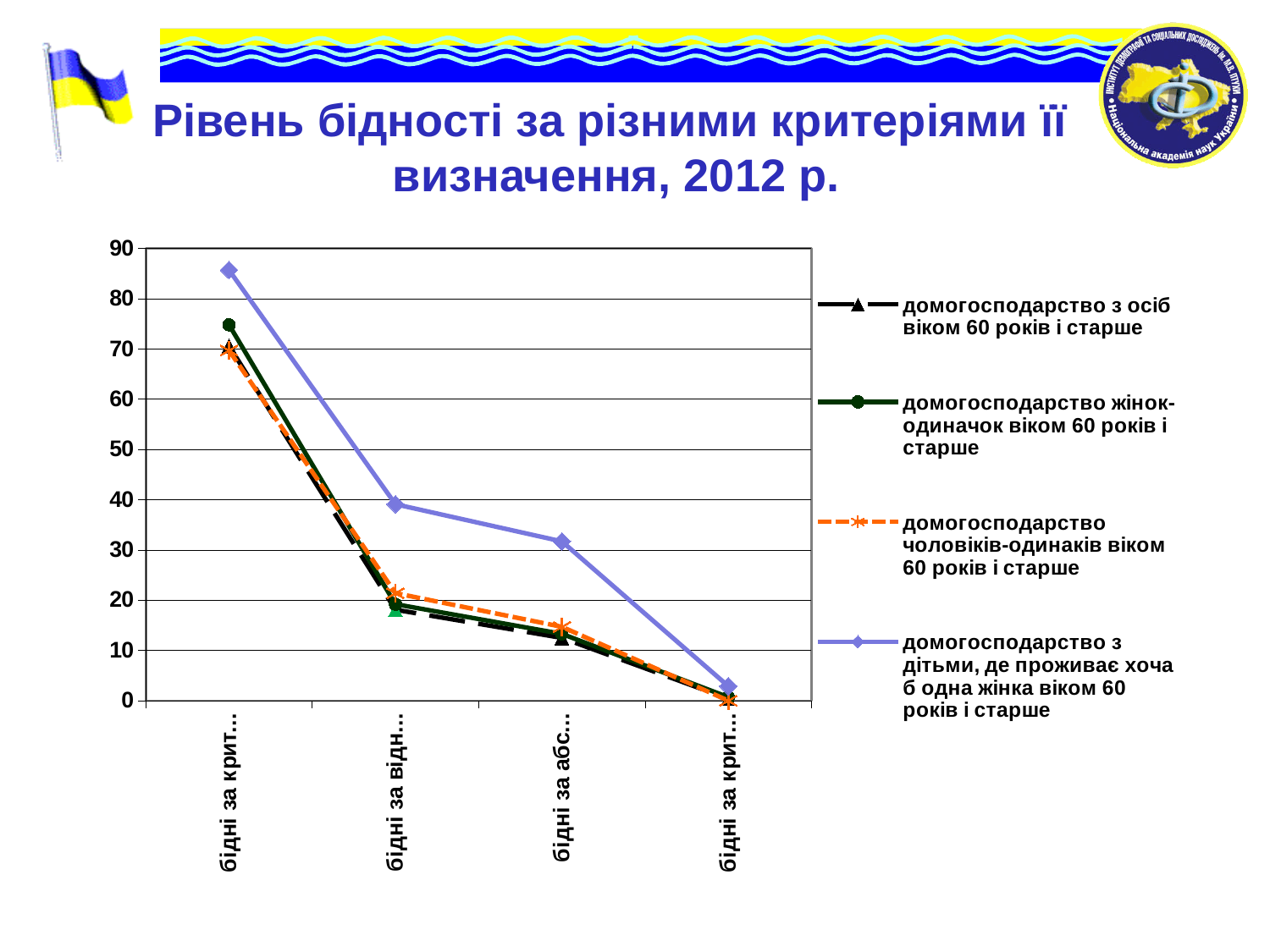
How many series does the legend list? 4 What is the title of the chart on the slide? Рівень бідності за різними критеріями її визначення, 2012 р. Which series is drawn with a dashed orange line? домогосподарство чоловіків-одинаків віком 60 років і старше What kind of chart is shown on the slide? line chart Do the values of the series 'домогосподарство з дітьми, де проживає хоча б одна жінка віком 60 років і старше' rise or fall from left to right along the x axis? fall Is the value for 'домогосподарство жінок-одиначок віком 60 років і старше' at the first category greater or less than 70? greater Is the value for 'домогосподарство з дітьми, де проживає хоча б одна жінка віком 60 років і старше' at the first category greater or less than 80? greater Is the value for 'домогосподарство з дітьми, де проживає хоча б одна жінка віком 60 років і старше' at the second category greater or less than 30? greater How many categories are plotted along the x axis? 4 Which series has the highest value at the first category on the x axis? домогосподарство з дітьми, де проживає хоча б одна жінка віком 60 років і старше At the third category, which series has the larger value: 'домогосподарство з дітьми, де проживає хоча б одна жінка віком 60 років і старше' or 'домогосподарство з осіб віком 60 років і старше'? домогосподарство з дітьми, де проживає хоча б одна жінка віком 60 років і старше